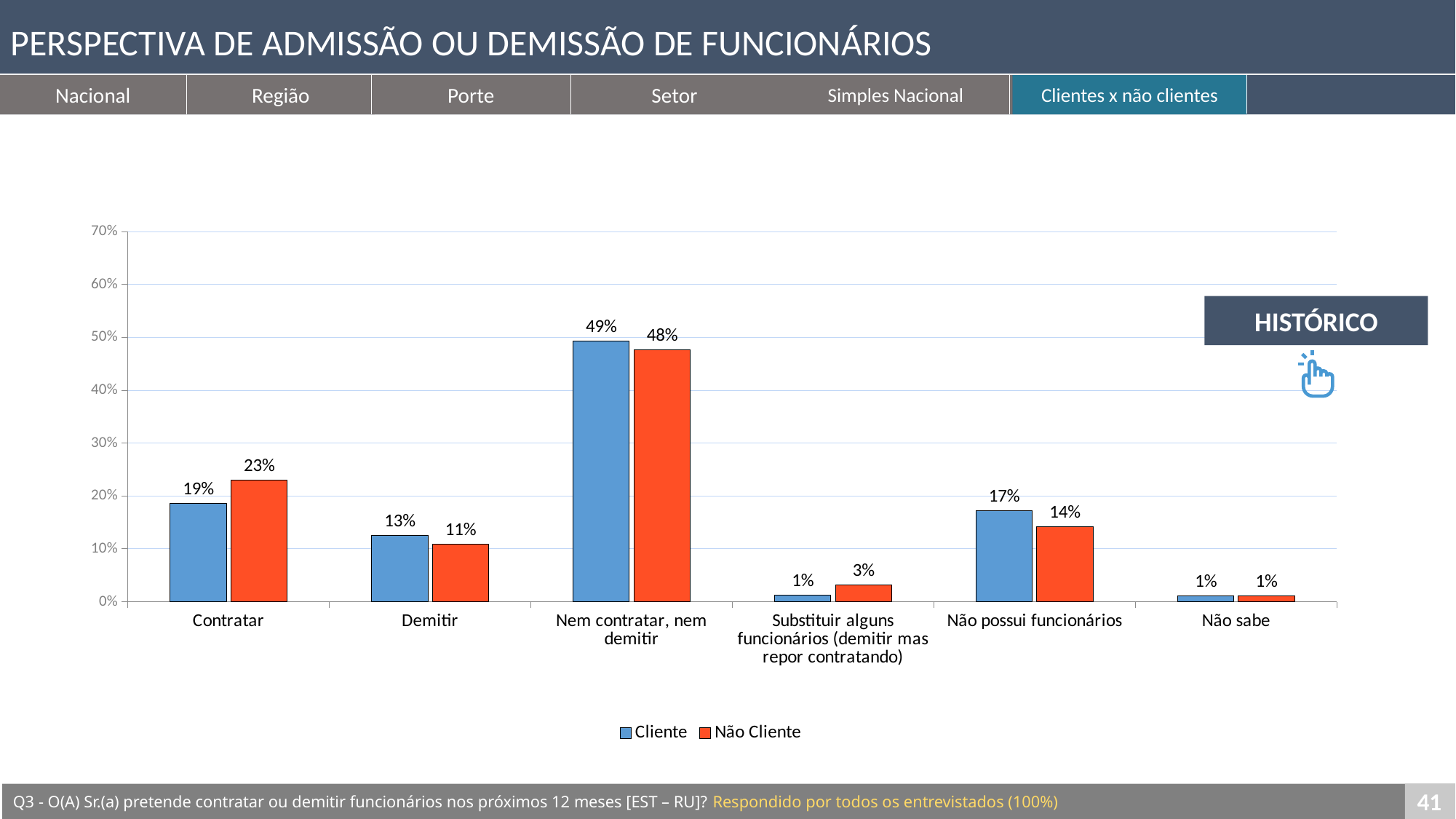
Is the value for Cliente in the Nem contratar, nem demitir category greater or less than 40%? greater What is the value for Cliente in the Contratar category? 19% What is the value for Não Cliente in the Substituir alguns funcionários (demitir mas repor contratando) category? 3% How many series does the legend list? 2 How many categories are shown on the x axis? 6 Which is larger in the Demitir category, Cliente or Não Cliente? Cliente What is the difference between Não Cliente and Cliente in the Contratar category? 4% Which series is shown in orange in the legend? Não Cliente What is the value for Não Cliente in the Demitir category? 11% Which category has the highest value for the Cliente series? Nem contratar, nem demitir What is the difference between Cliente and Não Cliente in the Não possui funcionários category? 3% What kind of chart is shown on the slide? Bar chart